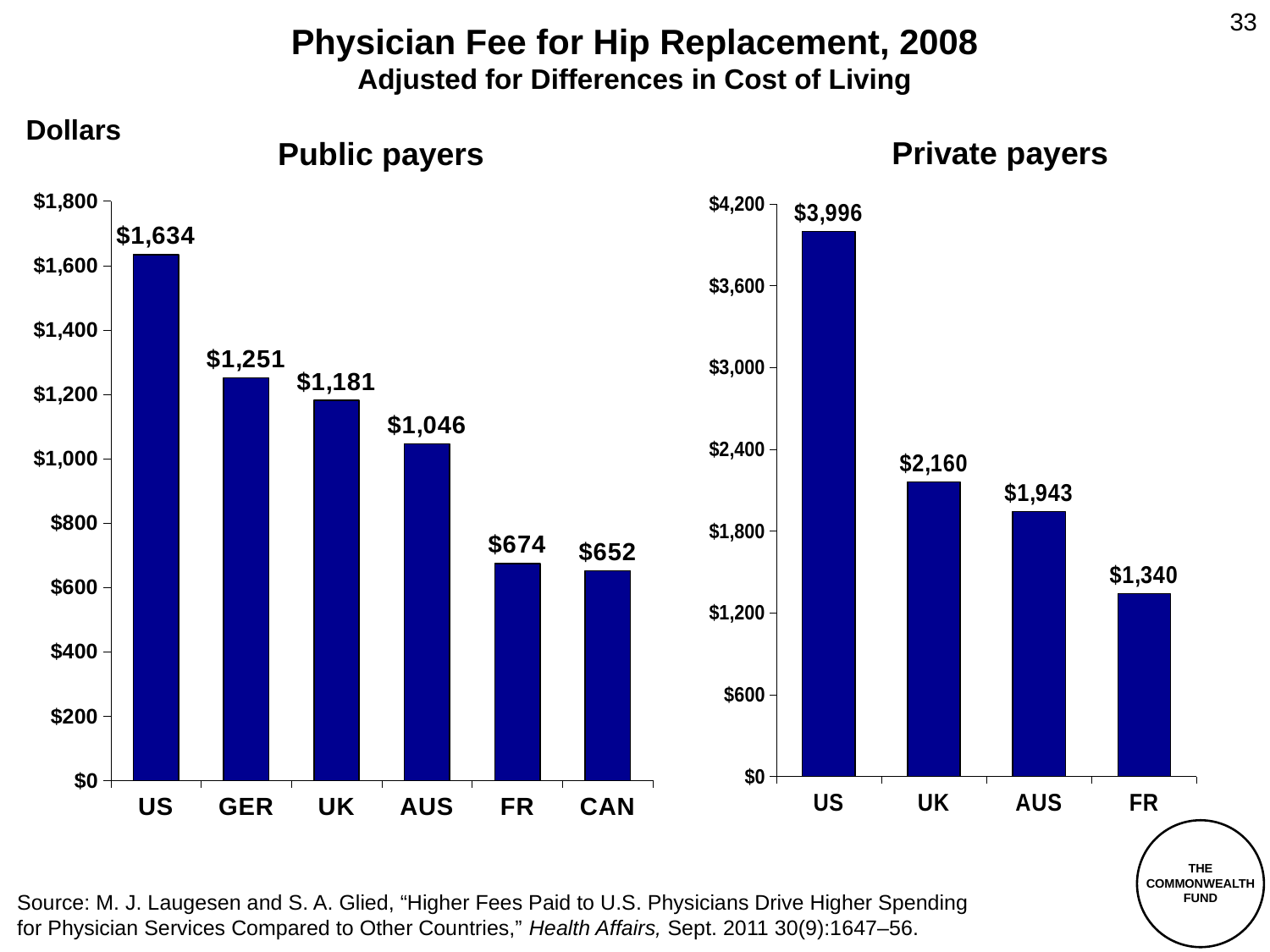
What kind of chart is the Private payers chart? Bar chart In the Private payers chart, what is the difference between the US fee and the UK fee? $1,836 In the Public payers chart, which country has the lowest physician fee? CAN In the Private payers chart, is the value for UK greater or less than $2,400? less How many countries are shown in the Private payers chart? 4 In the Public payers chart, which country has the highest physician fee? US In the Private payers chart, what is the physician fee for AUS? $1,943 How many countries are shown in the Public payers chart? 6 In the Public payers chart, what is the difference between the FR fee and the CAN fee? $22 In the Public payers chart, which is larger, the fee for UK or the fee for AUS? UK In the Private payers chart, which country has the lowest physician fee? FR In the Public payers chart, what is the physician fee for GER? $1,251